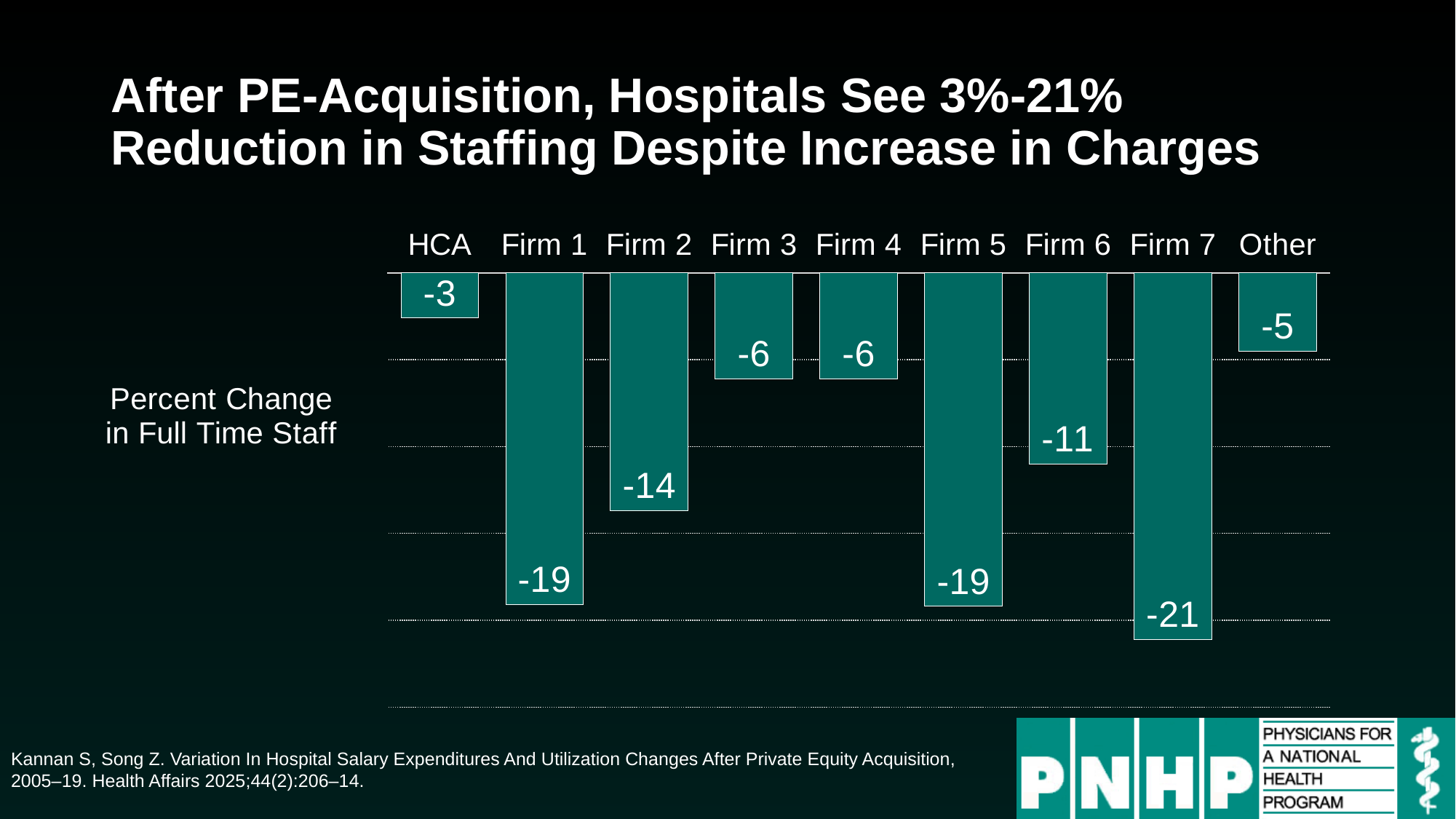
Which category shows the largest reduction in full time staff? Firm 7 Which category shows the smallest reduction in full time staff? HCA How many categories are shown on the chart? 9 What is the difference between the values for Firm 7 and Firm 2? 7 Which two firms both have a value of -19? Firm 1 and Firm 5 Which has a larger reduction in full time staff, Firm 6 or Firm 3? Firm 6 What is the percent change in full time staff for Firm 6? -11 What is the percent change in full time staff for HCA? -3 What does the axis label to the left of the chart say? Percent Change in Full Time Staff What kind of chart is shown on the slide? Bar chart What is the percent change in full time staff for Firm 2? -14 What is the percent change in full time staff for Other? -5